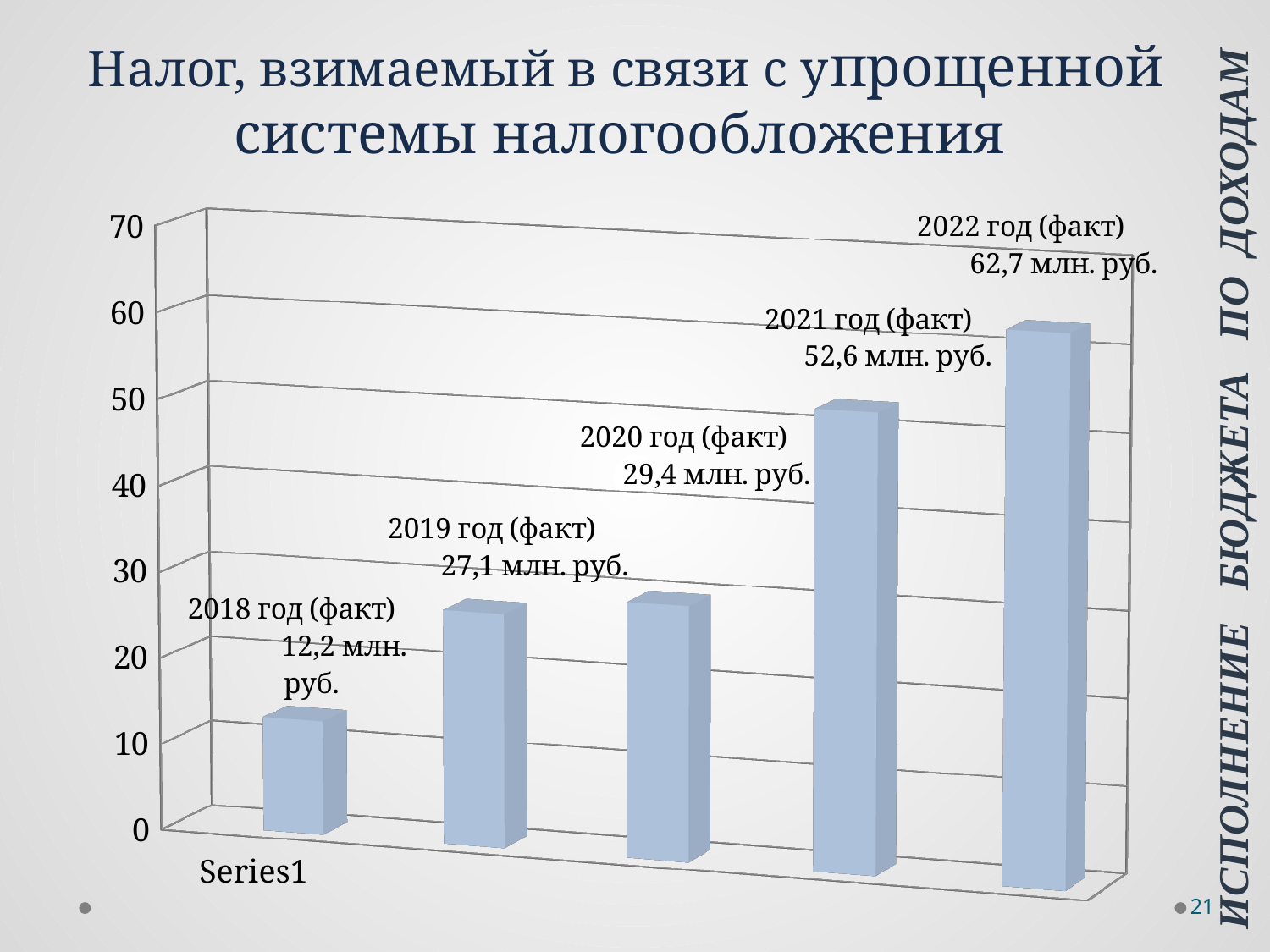
What value is shown for 2020 год (факт)? 29,4 млн. руб. Which is larger, the value for 2019 год (факт) or 2020 год (факт)? 2020 год (факт) What kind of chart is shown on the slide? bar chart Do the values rise or fall from 2018 to 2022? rise What value is shown for 2021 год (факт)? 52,6 млн. руб. What value is shown for 2018 год (факт)? 12,2 млн. руб. What is the difference between the values for 2022 год (факт) and 2021 год (факт)? 10,1 млн. руб. Which year has the lowest value on the chart? 2018 год (факт) How many bars are plotted on the chart? 5 Is the value for 2021 год (факт) greater or less than 50? greater What is the difference between the values for 2019 год (факт) and 2018 год (факт)? 14,9 млн. руб. Which year has the highest value on the chart? 2022 год (факт)